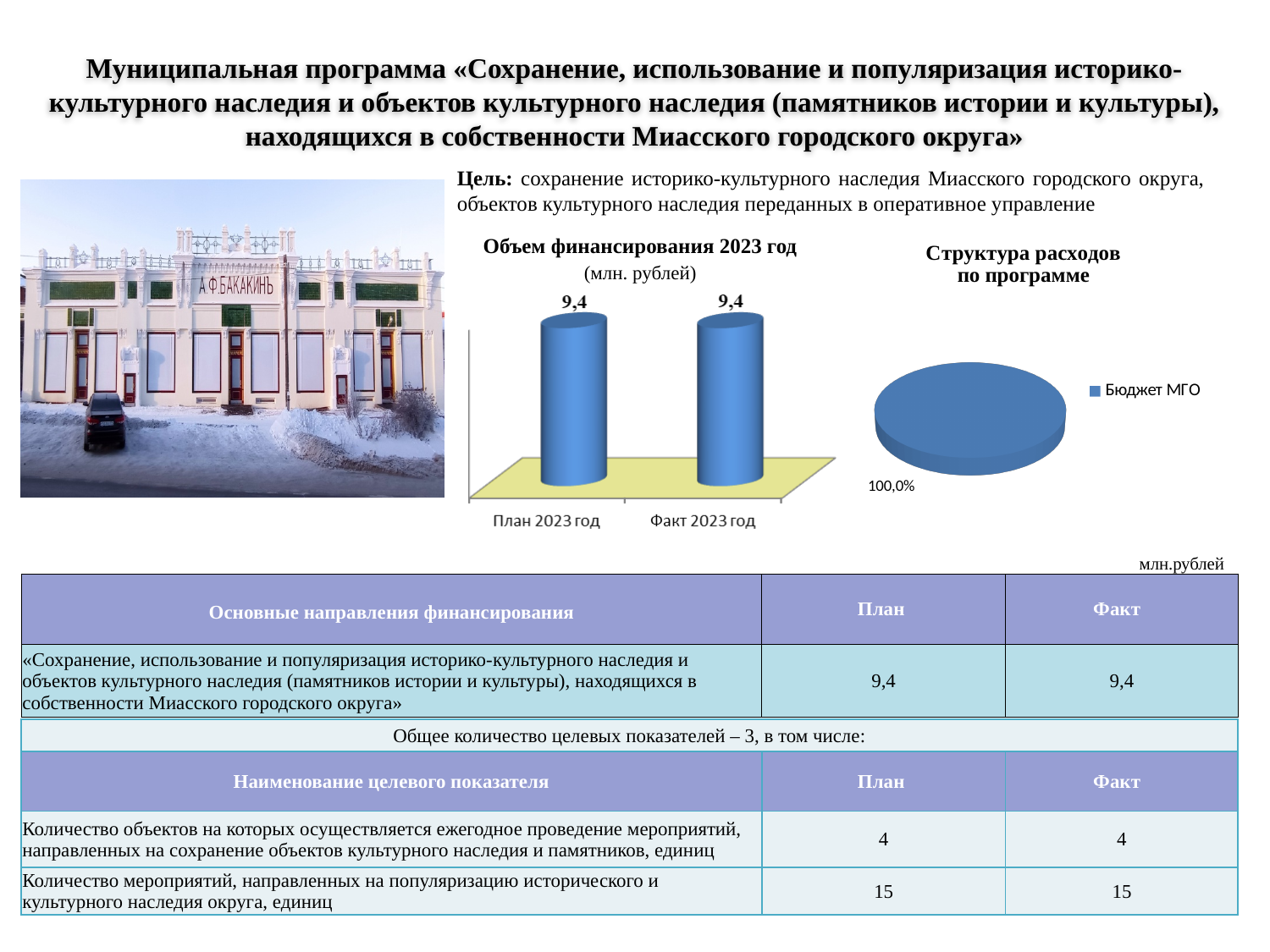
How many entries does the legend of the chart 'Структура расходов по программе' list? 1 In the chart 'Объем финансирования 2023 год', what is the difference between the values for План 2023 год and Факт 2023 год? 0,0 In the chart 'Объем финансирования 2023 год', what unit is given under the title? млн. рублей In the chart 'Структура расходов по программе', what is the name of the only legend entry? Бюджет МГО In the chart 'Структура расходов по программе', how many slices does the pie have? 1 What kind of chart is 'Структура расходов по программе'? pie chart In the chart 'Объем финансирования 2023 год', what is the value for Факт 2023 год? 9,4 In the chart 'Структура расходов по программе', what share does Бюджет МГО have? 100,0% In the chart 'Объем финансирования 2023 год', how many bars are plotted? 2 What kind of chart is 'Объем финансирования 2023 год'? bar chart In the chart 'Объем финансирования 2023 год', what is the value for План 2023 год? 9,4